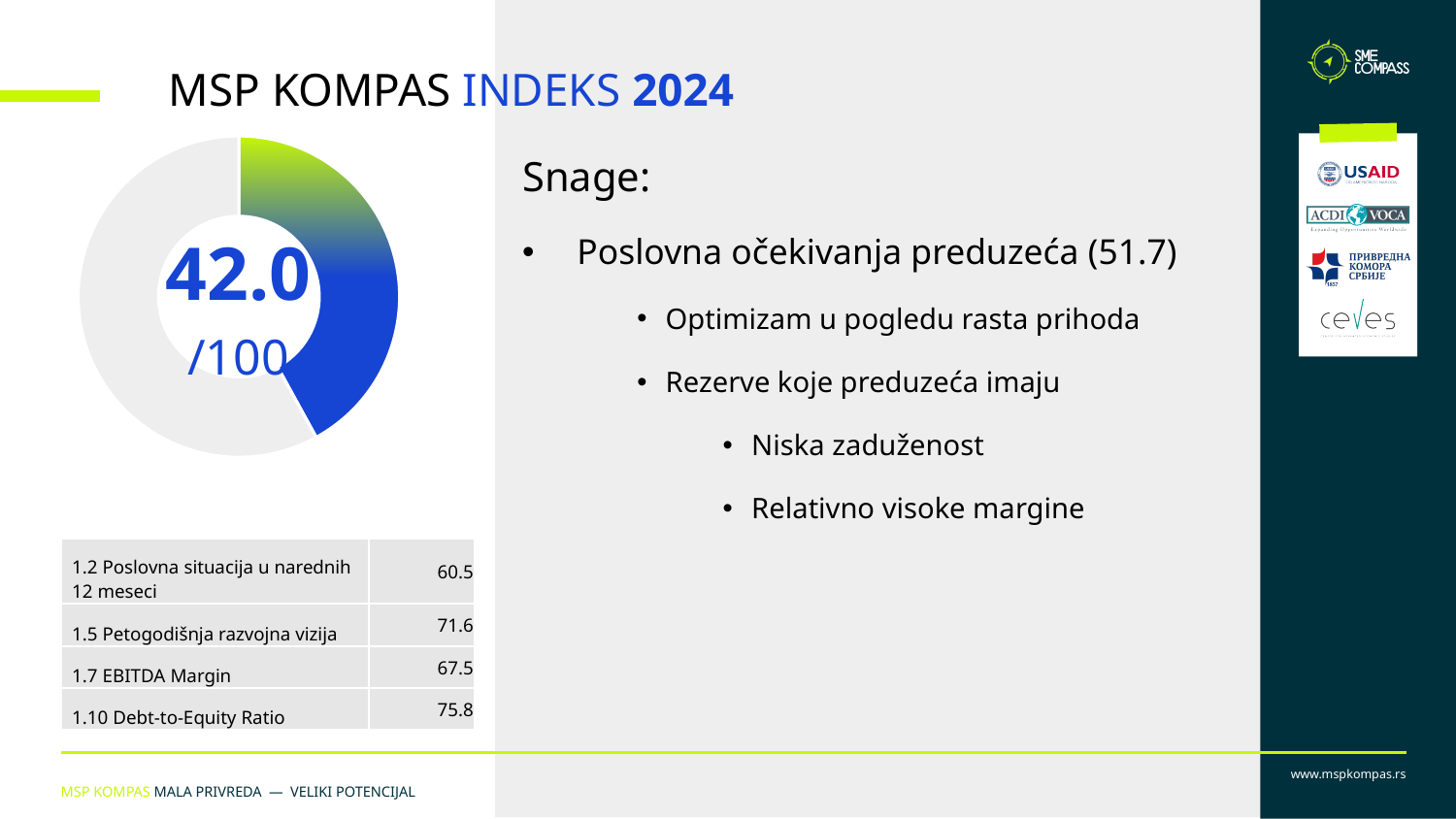
Out of what maximum is the value in the donut chart expressed? 100 Is the coloured portion of the donut chart larger or smaller than the grey remainder? smaller What kind of chart is shown on the left of the slide? donut (pie) chart What value is displayed in the centre of the donut chart? 42.0 What is the title of the slide containing the donut chart? MSP KOMPAS INDEKS 2024 Is the value shown in the donut chart greater or less than 50? less How many segments does the donut chart have (coloured portion and grey remainder)? 2 Is the value shown in the donut chart greater or less than 40? greater